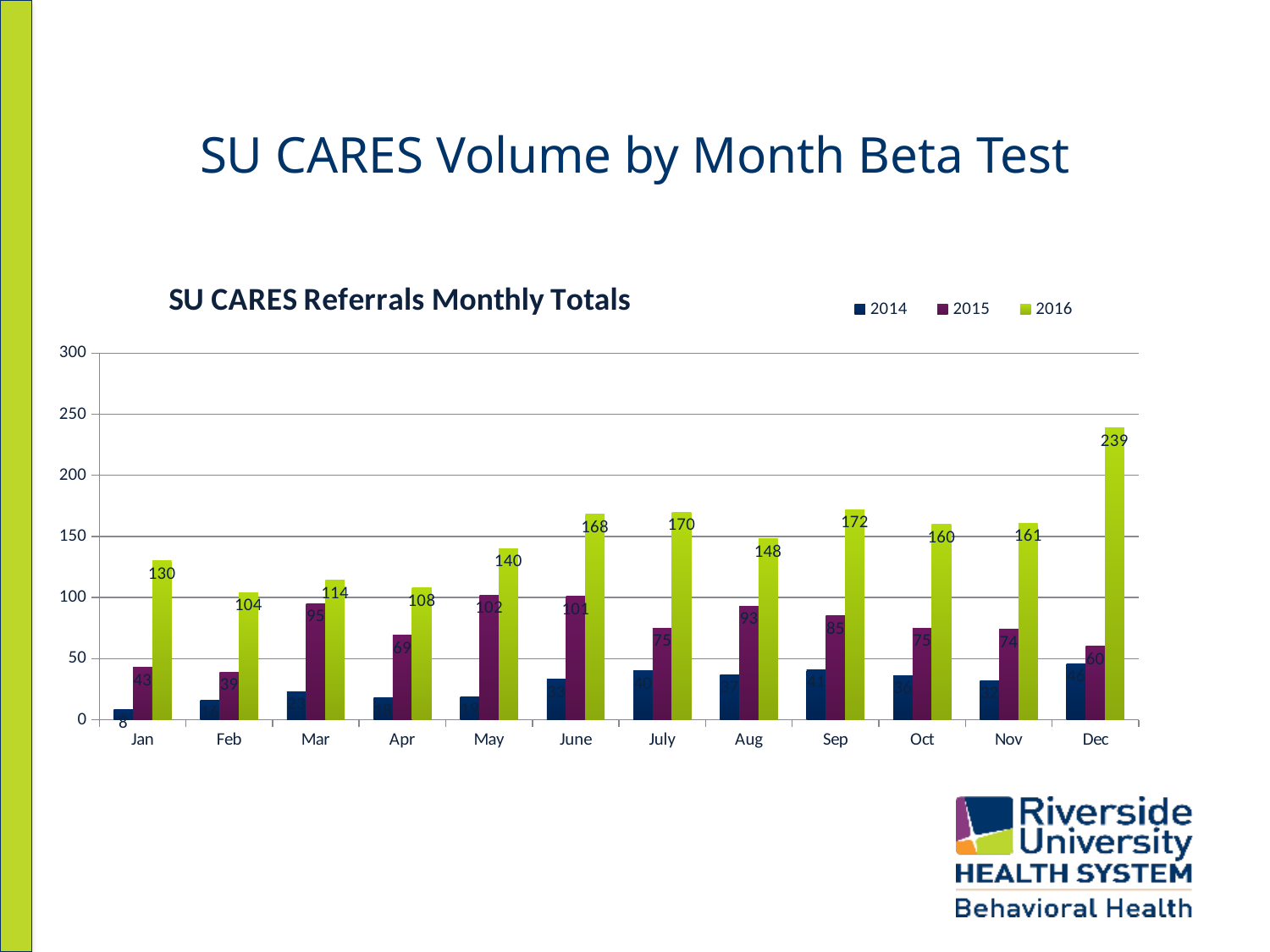
What is the value for 2015 in Mar? 95 Which is larger for 2015: Mar or Apr? Mar What is the value for 2016 in Dec? 239 How many months are shown on the x axis? 12 What is the difference between the 2016 values for Dec and Nov? 78 Is the value for 2014 in Mar greater or less than 50? less What kind of chart is this? bar chart How many series does the legend list? 3 What is the value for 2014 in Jan? 8 Which month has the lowest value for 2015? Feb Which month has the highest value for 2016? Dec What is the value for 2016 in Sep? 172